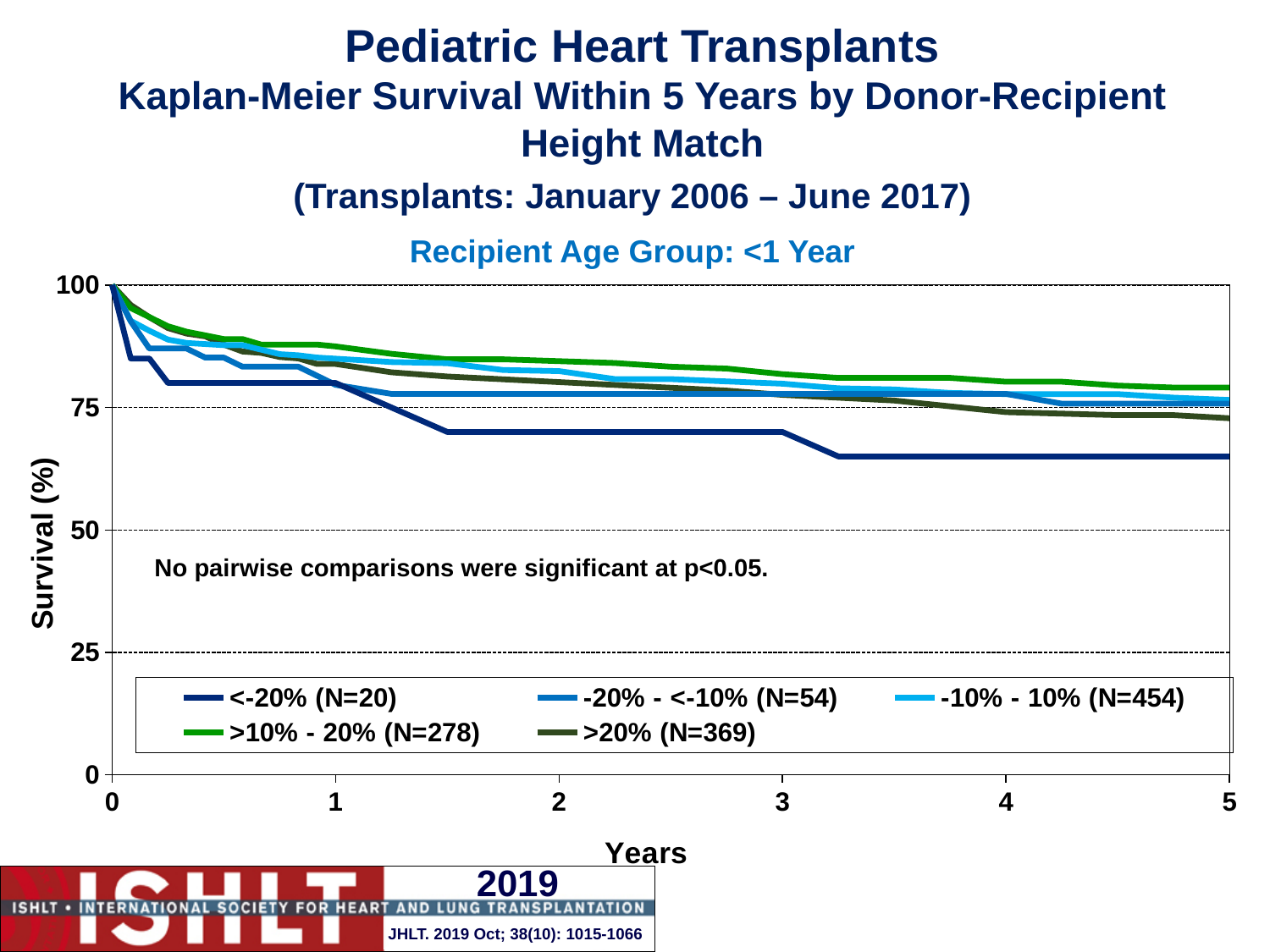
Is the survival for the >20% group at 5 years greater or less than 75? less How many patients (N) are in the -10% - 10% height-match group? 454 Is the survival for the >10% - 20% group at 5 years greater or less than 75? greater Is the survival for the <-20% group at 3 years greater or less than 75? less What kind of chart is shown on the slide? line chart Does survival rise or fall as years since transplant increase? fall What recipient age group does the chart cover? <1 Year Which height-match group has the lowest survival at 5 years? <-20% (N=20) How many series does the legend list? 5 Which height-match group has the highest survival at 5 years? >10% - 20% (N=278) What is the survival value for all groups at year 0? 100